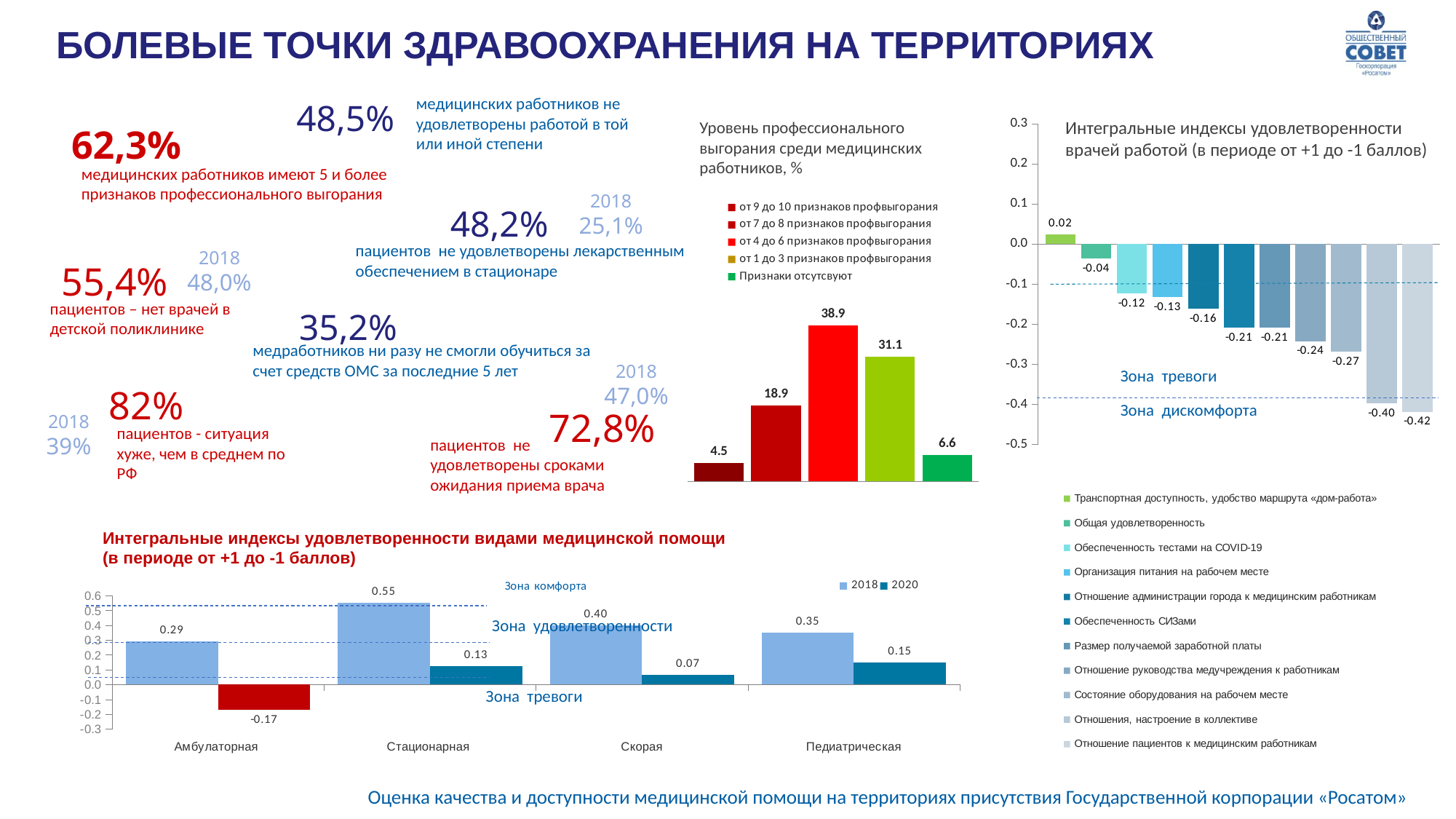
In the chart 'Интегральные индексы удовлетворенности видами медицинской помощи', what is the difference between the 2018 and 2020 values for 'Стационарная'? 0.42 In the chart 'Уровень профессионального выгорания среди медицинских работников, %', what is the difference between 'от 4 до 6 признаков профвыгорания' and 'от 1 до 3 признаков профвыгорания'? 7.8 How many entries does the legend of the chart 'Уровень профессионального выгорания среди медицинских работников, %' list? 5 What kind of chart is 'Интегральные индексы удовлетворенности видами медицинской помощи'? Bar chart In the chart 'Интегральные индексы удовлетворенности видами медицинской помощи', what is the 2020 value for 'Амбулаторная'? -0.17 How many bars are plotted in the chart 'Интегральные индексы удовлетворенности врачей работой'? 11 In the chart 'Интегральные индексы удовлетворенности врачей работой', what is the value for 'Обеспеченность тестами на COVID-19'? -0.12 In the chart 'Уровень профессионального выгорания среди медицинских работников, %', what is the value for 'от 4 до 6 признаков профвыгорания'? 38.9 In the chart 'Интегральные индексы удовлетворенности врачей работой', which category has the highest value? Транспортная доступность, удобство маршрута «дом-работа» In the chart 'Интегральные индексы удовлетворенности врачей работой', which category has the lowest value? Отношение пациентов к медицинским работникам In the chart 'Уровень профессионального выгорания среди медицинских работников, %', which category has the lowest value? от 9 до 10 признаков профвыгорания In the chart 'Интегральные индексы удовлетворенности видами медицинской помощи', which is larger: the 2020 value for 'Педиатрическая' or the 2020 value for 'Скорая'? Педиатрическая